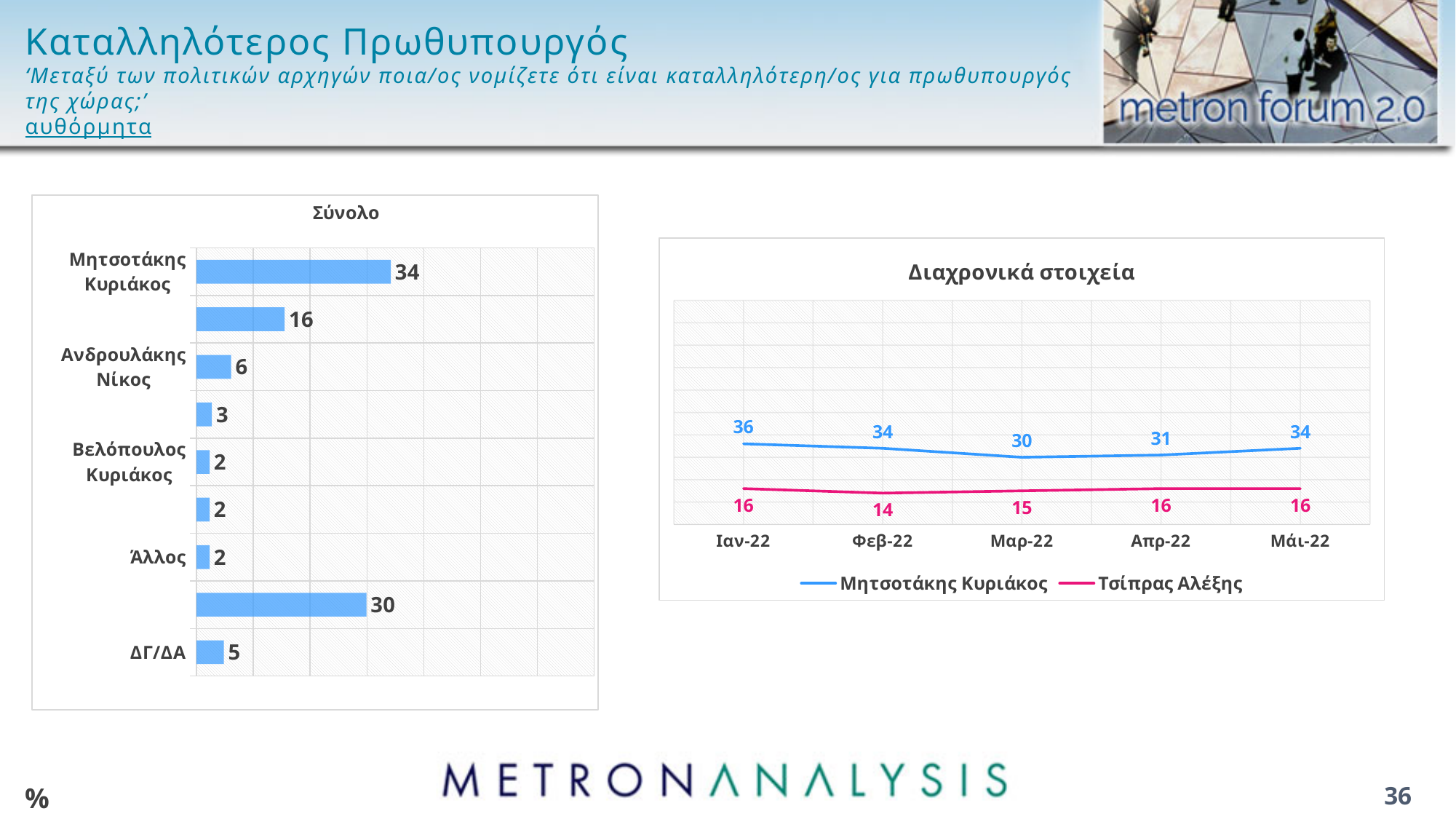
In the 'Σύνολο' chart, how many bars are plotted? 9 In the 'Διαχρονικά στοιχεία' chart, what is the value for Τσίπρας Αλέξης in Φεβ-22? 14 In the 'Σύνολο' chart, what is the value for Μητσοτάκης Κυριάκος? 34 In the 'Σύνολο' chart, which labelled category has the highest value? Μητσοτάκης Κυριάκος In the 'Διαχρονικά στοιχεία' chart, what is the difference between Μητσοτάκης Κυριάκος and Τσίπρας Αλέξης in Μάι-22? 18 In the 'Διαχρονικά στοιχεία' chart, what is the value for Μητσοτάκης Κυριάκος in Μαρ-22? 30 How many series does the legend of the 'Διαχρονικά στοιχεία' chart list? 2 In the 'Σύνολο' chart, what is the value for ΔΓ/ΔΑ? 5 In the 'Σύνολο' chart, what is the value for Ανδρουλάκης Νίκος? 6 What kind of chart is the 'Σύνολο' chart? Bar chart In the 'Διαχρονικά στοιχεία' chart, in which month is the value for Μητσοτάκης Κυριάκος highest? Ιαν-22 In the 'Σύνολο' chart, what is the difference between the values for Μητσοτάκης Κυριάκος and Ανδρουλάκης Νίκος? 28